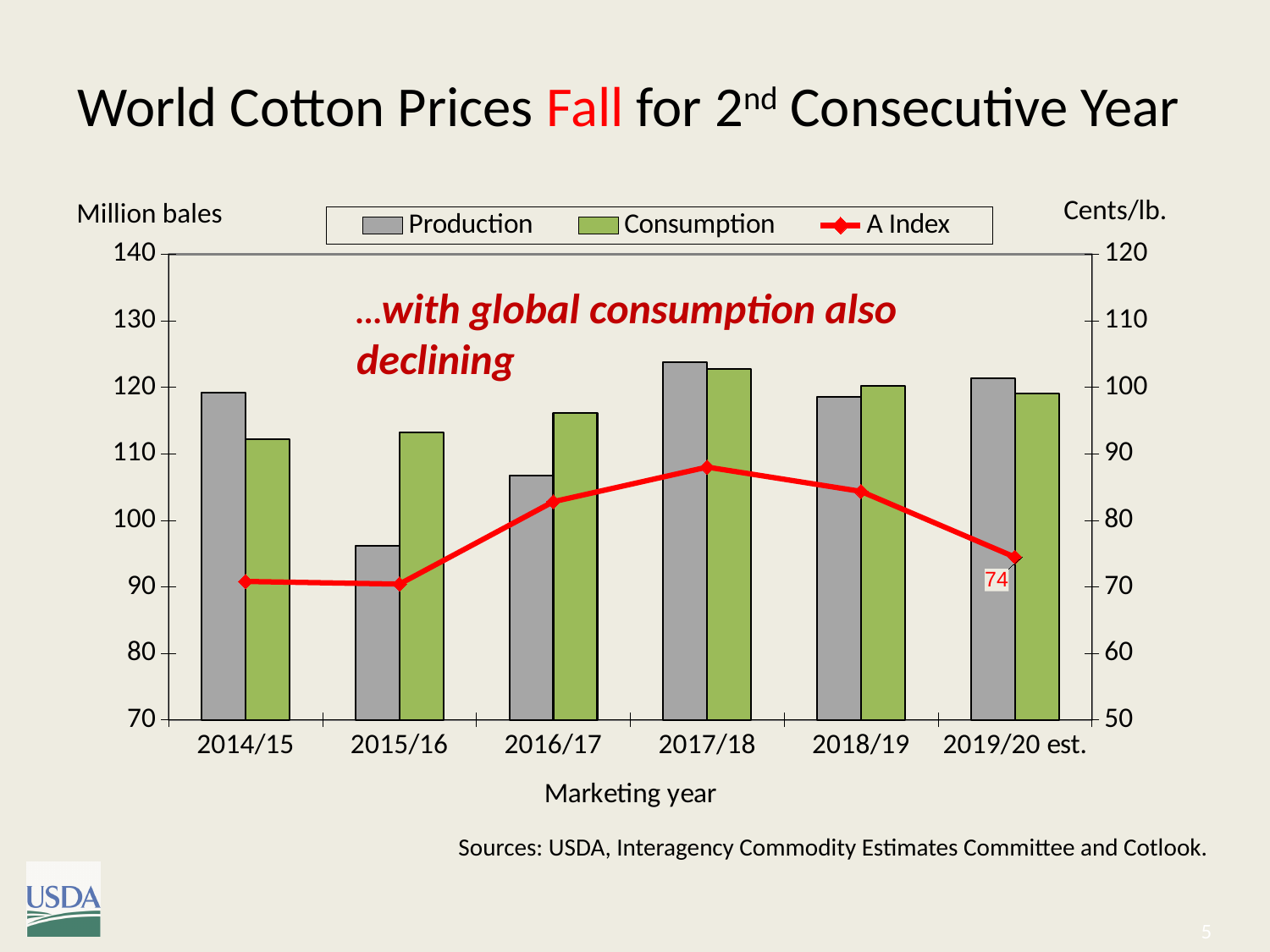
Is the Consumption value for 2017/18 greater or less than 120 million bales? greater Is the Production value for 2015/16 greater or less than 100 million bales? less In which marketing year is Production lowest? 2015/16 What unit is shown on the right-hand axis? Cents/lb. Does the A Index rise or fall from 2017/18 to 2019/20 est.? Fall How many marketing years are shown on the x axis? 6 What kind of chart is this? A combination of a bar chart and a line chart What is the A Index value for 2019/20 est.? 74 In which marketing year is the A Index highest? 2017/18 In which marketing year is Production highest? 2017/18 How many series does the legend list? 3 In 2014/15, which is larger, Production or Consumption? Production